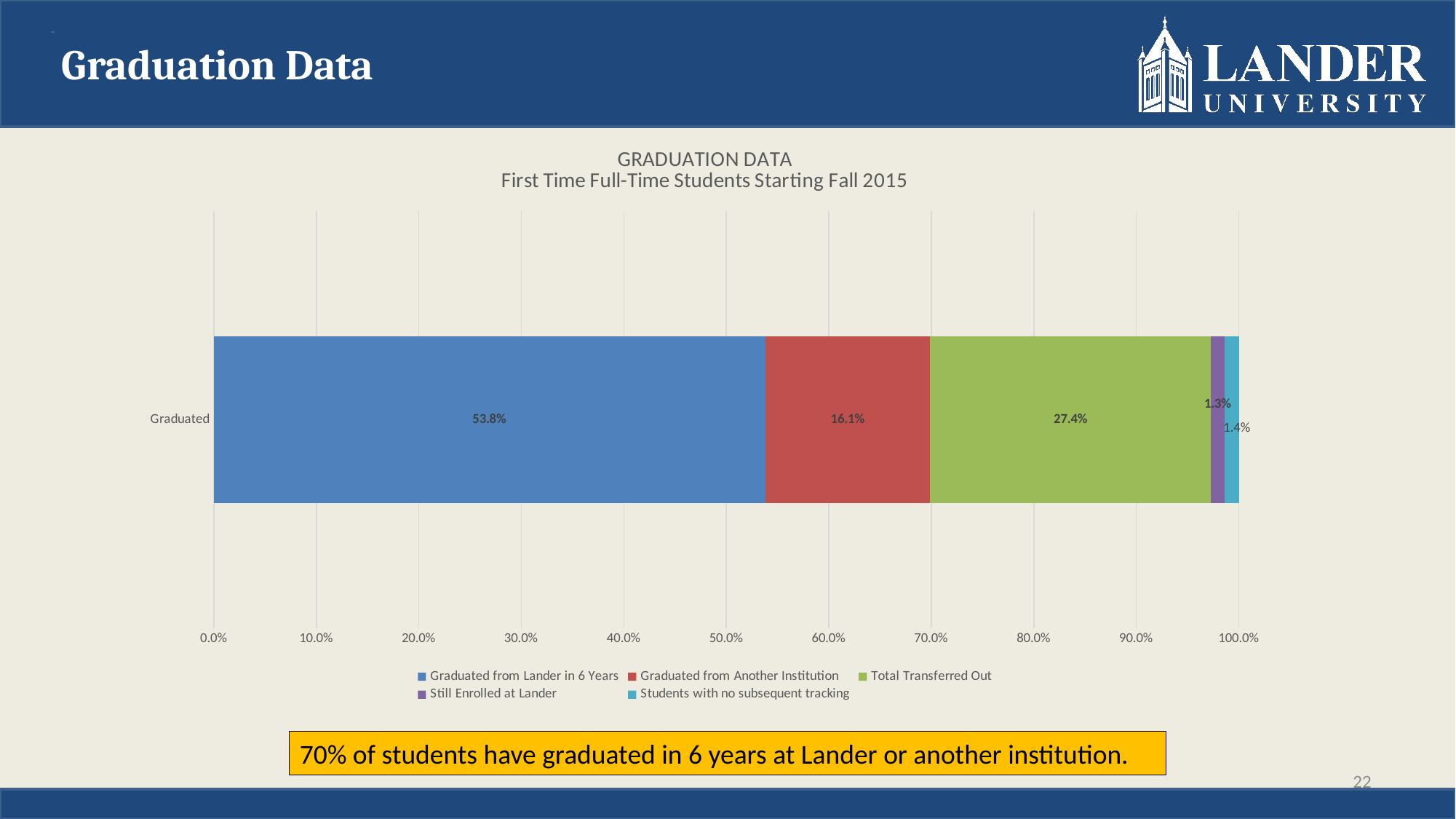
What is the value for Students with no subsequent tracking? 1.4% What is the difference between Graduated from Lander in 6 Years and Total Transferred Out? 26.4% What is the value for Total Transferred Out? 27.4% Which series has the largest share of the bar? Graduated from Lander in 6 Years What is the subtitle of the chart? First Time Full-Time Students Starting Fall 2015 What percentage of students graduated from Lander in 6 years? 53.8% What is the combined value of Graduated from Lander in 6 Years and Graduated from Another Institution? 69.9% How many series does the legend list? 5 What is the value for Graduated from Another Institution? 16.1% Which is larger, Graduated from Another Institution or Total Transferred Out? Total Transferred Out What is the value for Still Enrolled at Lander? 1.3% What kind of chart is shown on the slide? Stacked bar chart